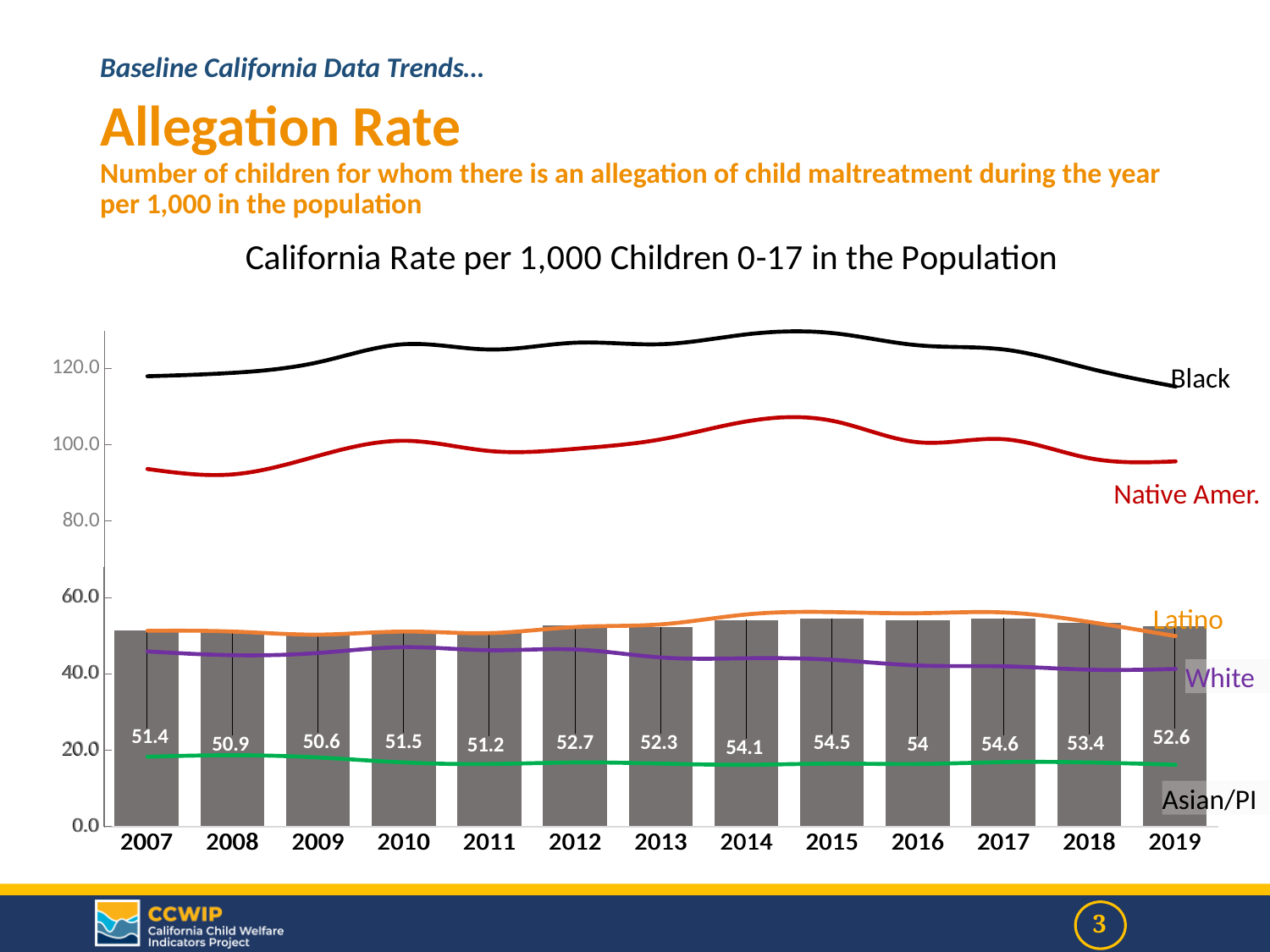
Which bar is larger, 2012 or 2013? 2012 How many years are shown on the x axis? 13 What is the difference between the bar values for 2017 and 2009? 4.0 Which year has the highest bar value? 2017 Is the value of the Asian/PI line in 2019 greater or less than 20.0? less What is the value of the bar for 2015? 54.5 What is the value of the bar for 2019? 52.6 What is the title of the chart? California Rate per 1,000 Children 0-17 in the Population Which year has the lowest bar value? 2009 What is the value of the bar for 2007? 51.4 Is the value of the Black line in 2007 greater or less than 100.0? greater Does the Black line rise or fall from 2015 to 2019? fall